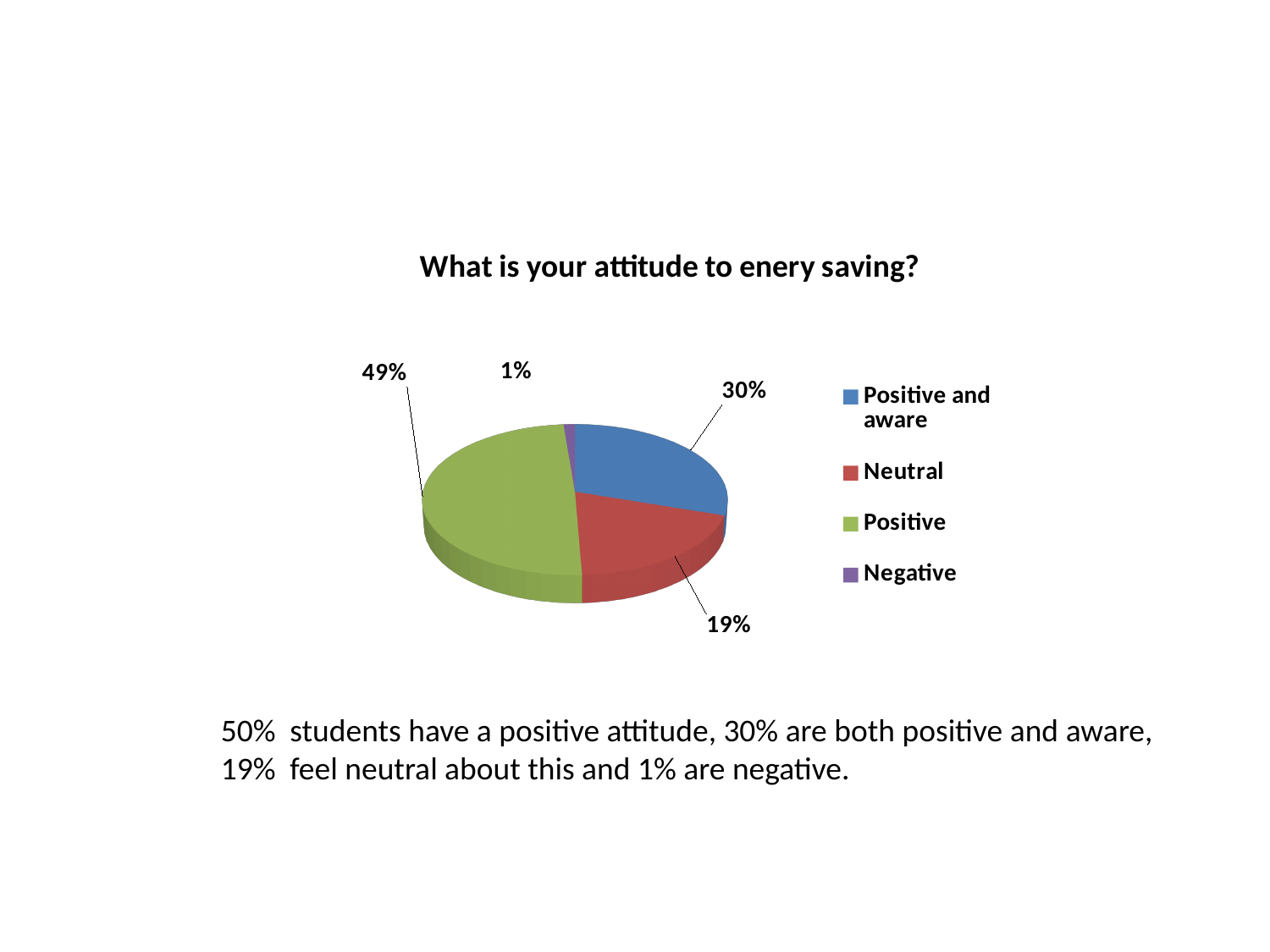
What share of the pie is labelled for the Positive and aware slice? 30% What share of the pie is labelled for the Neutral slice? 19% What share of the pie is labelled for the Positive slice? 49% What is the difference in percentage points between the Positive slice and the Neutral slice? 30 Which category has the smallest slice of the pie? Negative What kind of chart is shown on the slide? pie chart Which category has the largest slice of the pie? Positive How many categories does the legend list? 4 Which slice is larger, Positive and aware or Neutral? Positive and aware What is the title of the chart? What is your attitude to enery saving? What colour is the Neutral slice in the pie chart? red